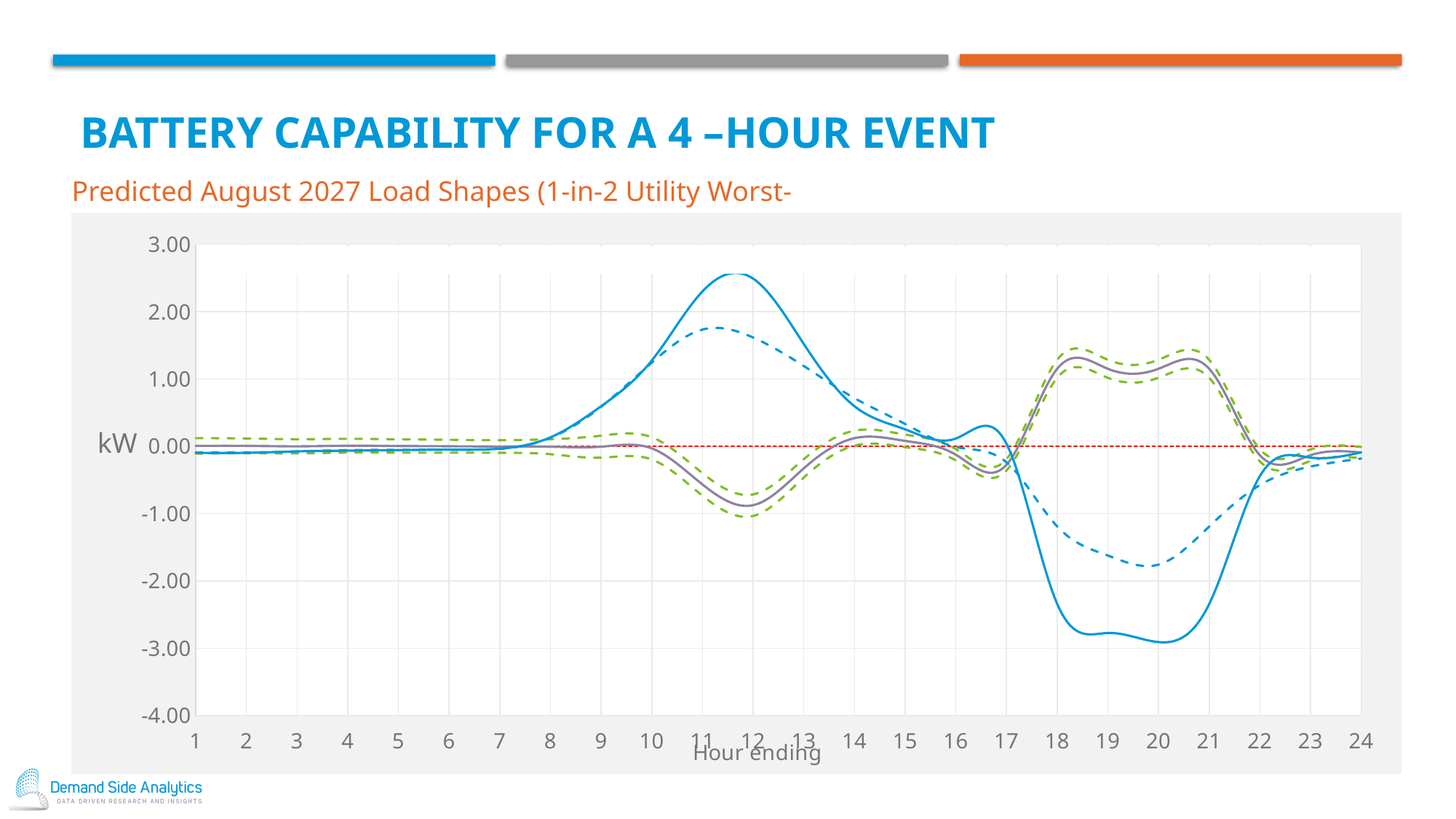
At hour 12, which is higher, the solid blue line or the dashed blue line? solid blue line Is the value of the solid blue line at hour 20 greater or less than -2.00? less Is the value of the solid purple line at hour 19 greater or less than 0.00? greater What is the label on the y axis of the chart? kW Is the value of the solid blue line at hour 12 greater or less than 2.00? greater Between hour 8 and hour 12, does the solid blue line rise or fall? rise How many hours are marked along the x axis of the chart? 24 Between hour 12 and hour 16, does the solid blue line rise or fall? fall What is the label on the x axis of the chart? Hour ending What kind of chart is shown on the slide? line chart